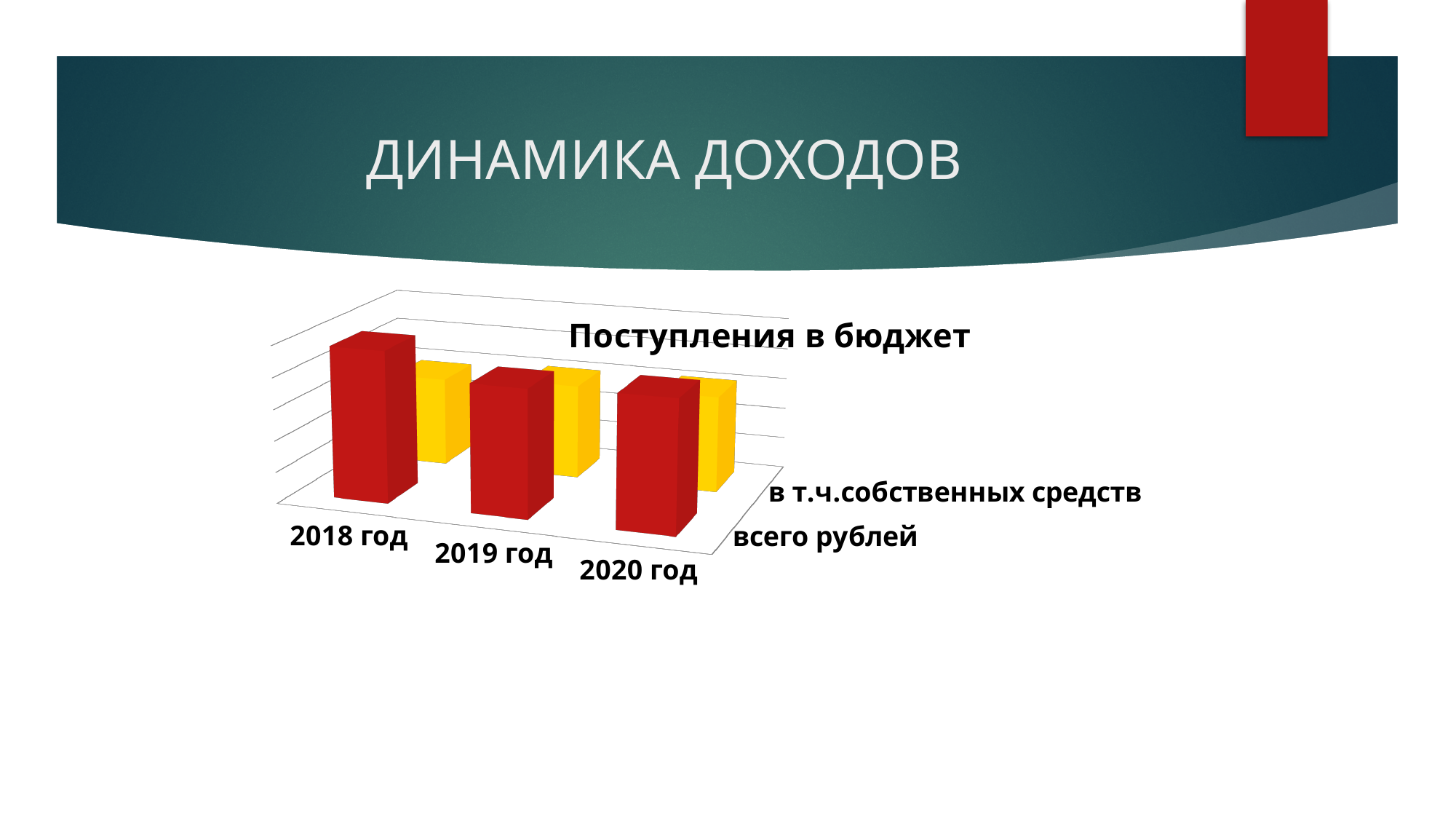
In 2020 год, is the bar for 'в т.ч.собственных средств' taller or shorter than the bar for 'всего рублей'? shorter For the series 'всего рублей', which year has the highest bar? 2018 год In 2018 год, which series has the taller bar: 'всего рублей' or 'в т.ч.собственных средств'? всего рублей For the series 'всего рублей', is the bar for 2018 год or 2019 год taller? 2018 год Which series is drawn in red in the chart? всего рублей What kind of chart is shown on the slide? bar chart What is the title of the chart? Поступления в бюджет How many bars are plotted in the chart in total? 6 How many year categories are shown on the x axis of the chart? 3